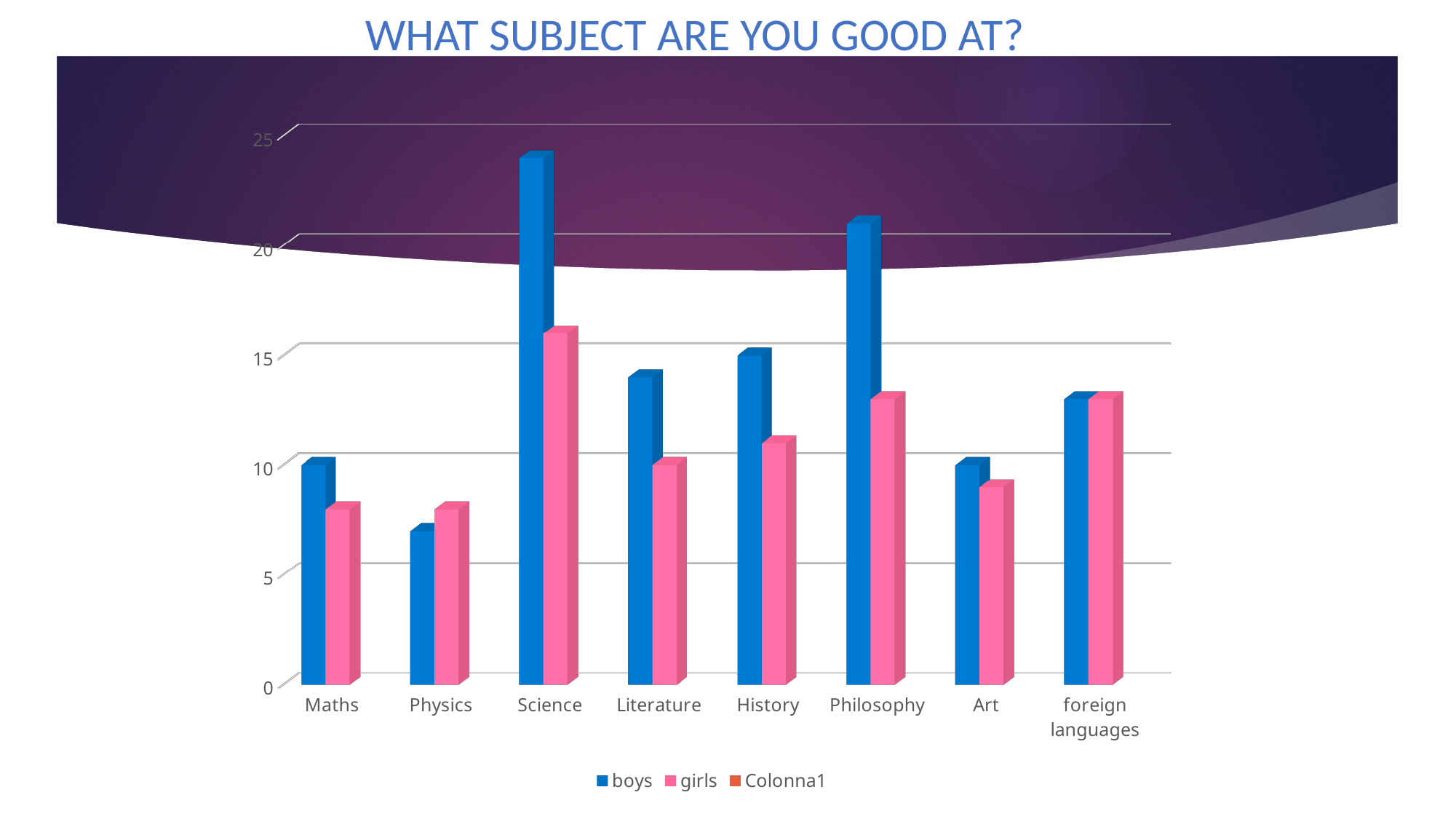
What is the title of the chart? WHAT SUBJECT ARE YOU GOOD AT? Which subject has the highest value for girls? Science For Science, which is larger, the value for boys or the value for girls? boys How many series does the legend list? 3 Is the value for boys in Physics greater or less than 10? less Which subject has the highest value for boys? Science Which subject has the lowest value for boys? Physics Is the value for girls in Science greater or less than 15? greater For Physics, which is larger, the value for boys or the value for girls? girls How many subject categories are shown on the x axis? 8 Is the value for boys in Philosophy greater or less than 20? greater What kind of chart is shown on the slide? bar chart